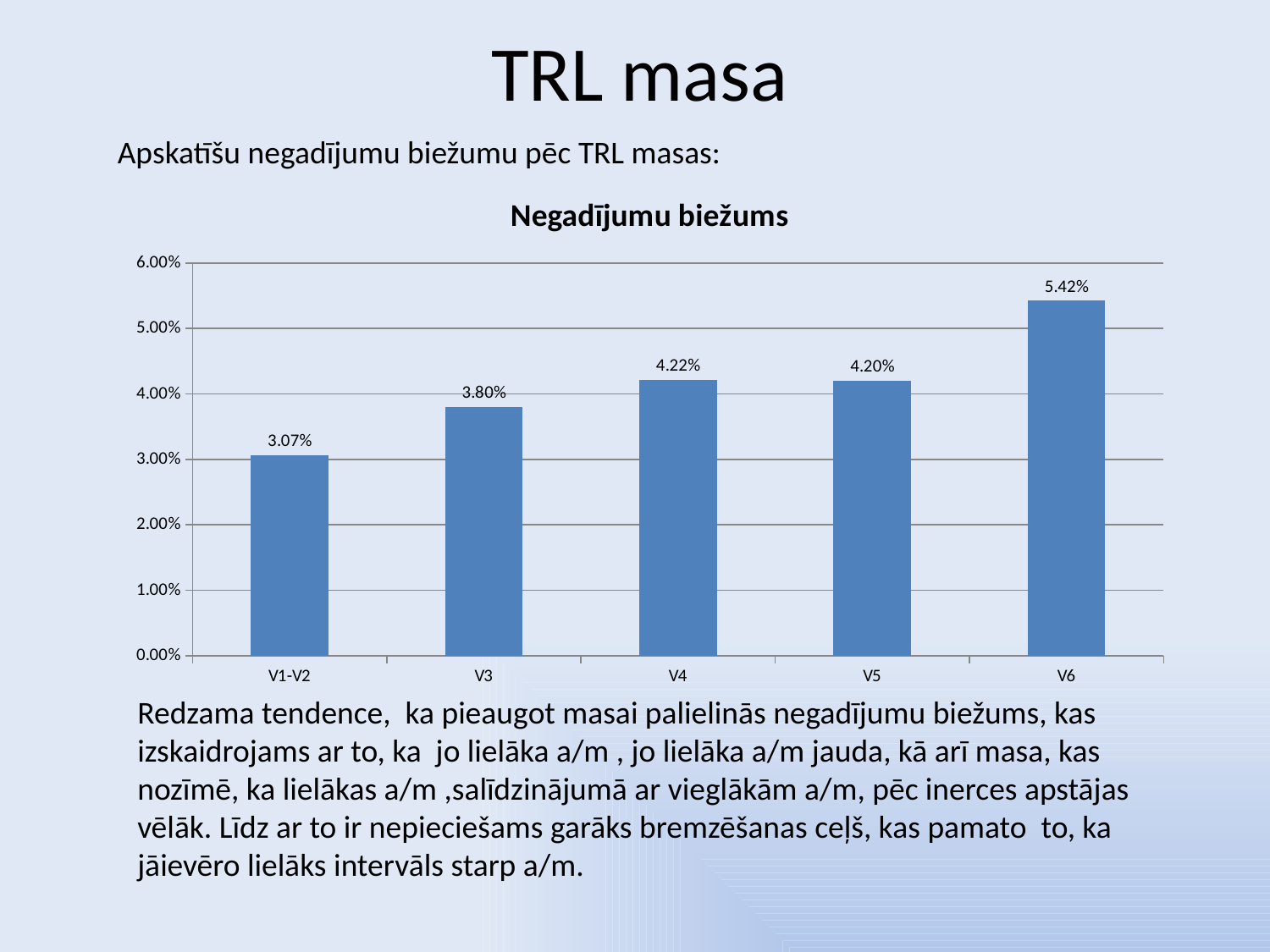
What is the difference between the values for V4 and V3? 0.42% How many categories are shown on the x axis? 5 What is the value for V1-V2? 3.07% What is the value for V3? 3.80% Which is larger, the value for V3 or the value for V5? V5 What kind of chart is shown on the slide? bar chart What is the value for V6? 5.42% Which category has the lowest value? V1-V2 Is the value for V6 greater or less than 5.00%? greater What is the difference between the values for V6 and V1-V2? 2.35% Which category has the highest value? V6 What is the title of the chart? Negadījumu biežums